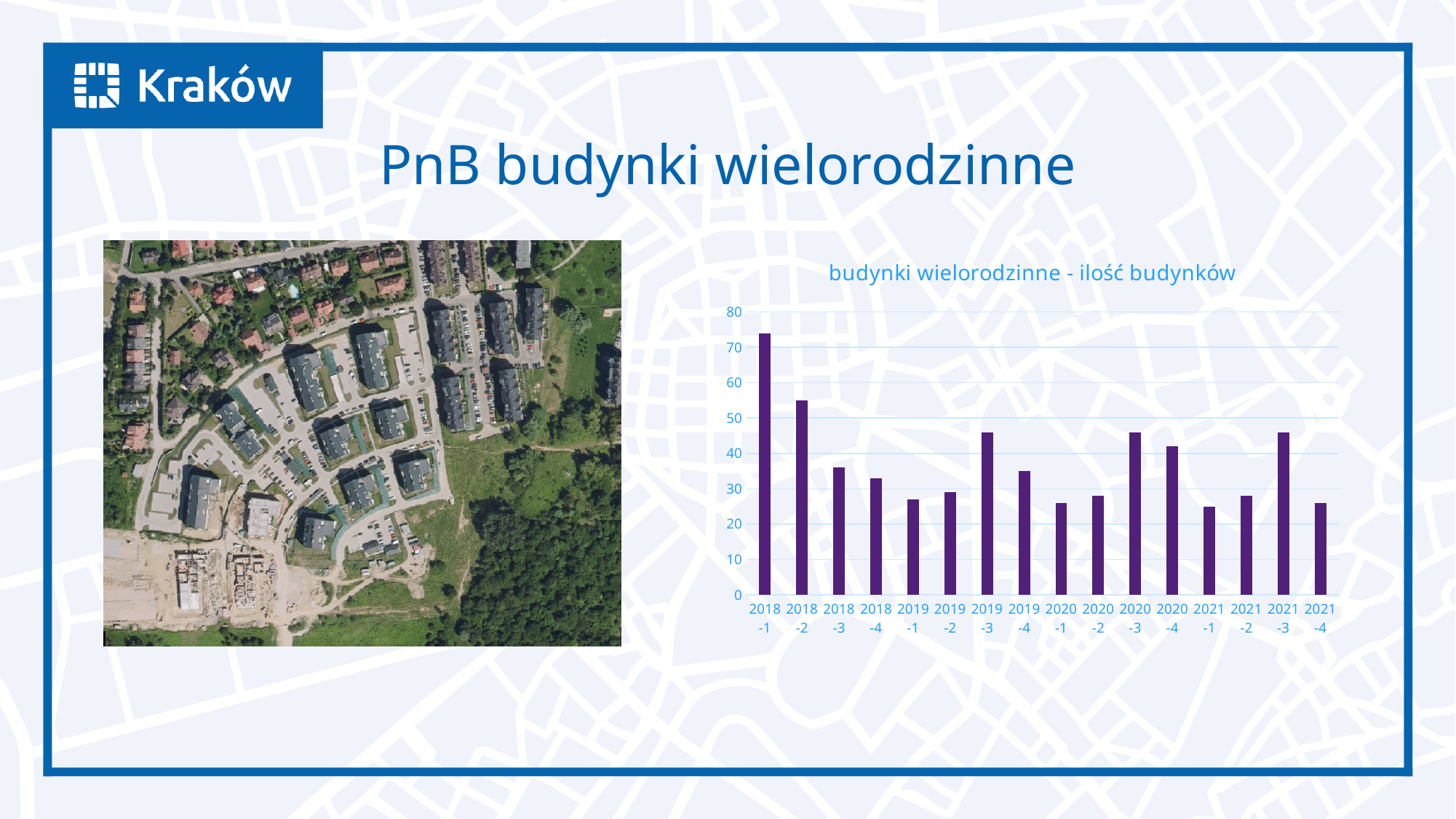
How many bars (quarters) are plotted in the chart? 16 Is the value for 2021-1 greater or less than 30? less Which quarter has the highest value in the chart? 2018-1 Is the value for 2020-4 greater or less than 50? less Which is larger, the value for 2018-2 or the value for 2018-3? 2018-2 Is the value for 2018-2 greater or less than 50? greater What is the title of the chart? budynki wielorodzinne - ilość budynków Do the values rise or fall across the four quarters of 2018? fall What kind of chart is shown on the slide? bar chart Which is larger, the value for 2020-4 or the value for 2021-4? 2020-4